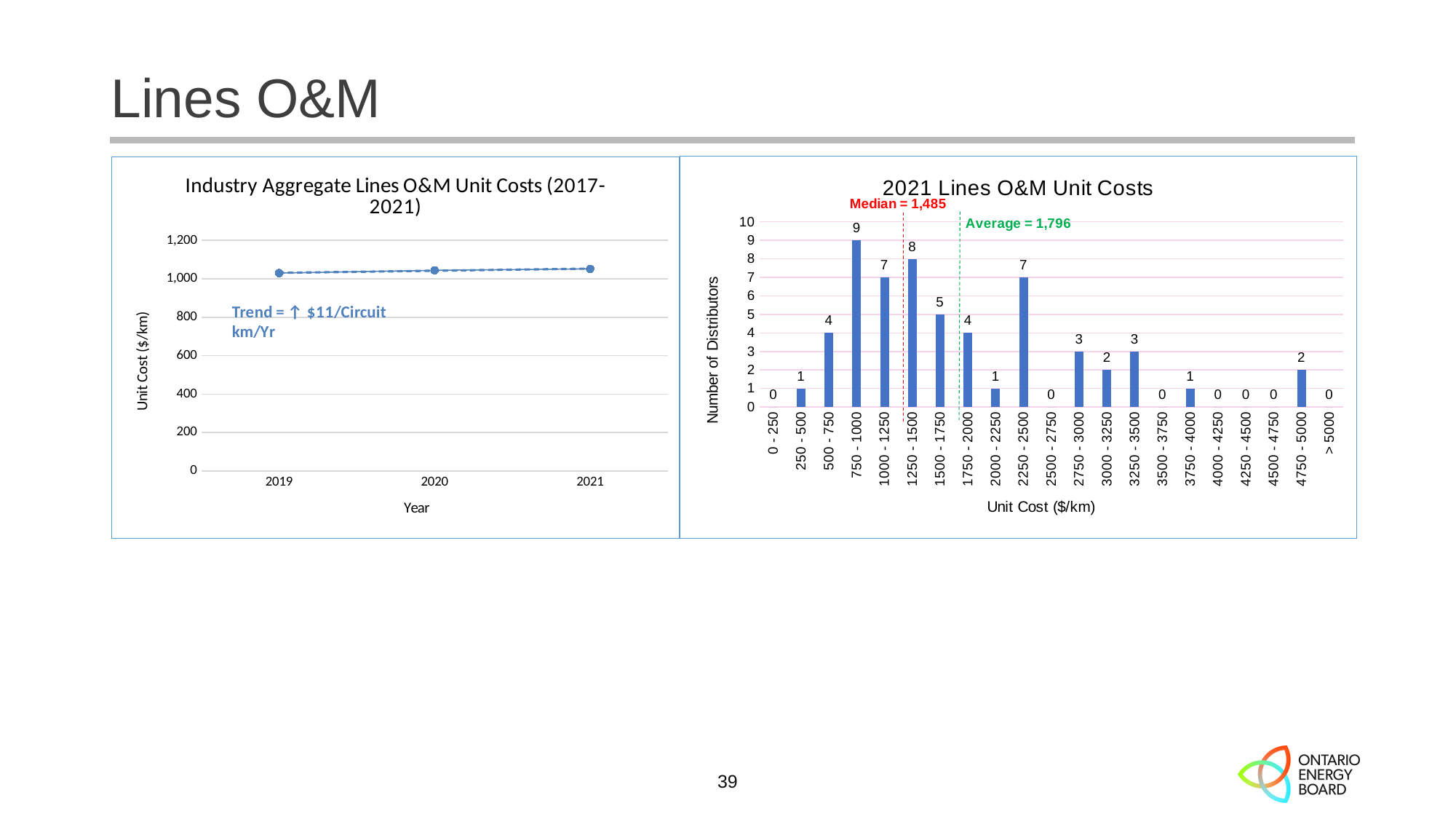
In the chart titled '2021 Lines O&M Unit Costs', how many distributors are in the 2250 - 2500 bin? 7 What kind of chart is the 'Industry Aggregate Lines O&M Unit Costs (2017-2021)' chart? Line chart In the chart titled '2021 Lines O&M Unit Costs', what is the difference between the number of distributors in the 1250 - 1500 bin and the 1500 - 1750 bin? 3 In the chart titled '2021 Lines O&M Unit Costs', what average value is annotated? 1,796 In the chart titled 'Industry Aggregate Lines O&M Unit Costs (2017-2021)', is the unit cost for 2021 greater or less than 1,000? greater In the chart titled '2021 Lines O&M Unit Costs', which bin has more distributors: 500 - 750 or 2750 - 3000? 500 - 750 In the chart titled '2021 Lines O&M Unit Costs', how many distributors fall in the 750 - 1000 bin? 9 What kind of chart is the '2021 Lines O&M Unit Costs' chart? Bar chart In the chart titled '2021 Lines O&M Unit Costs', how many unit cost bins are shown on the x axis? 21 In the chart titled '2021 Lines O&M Unit Costs', which unit cost bin has the highest number of distributors? 750 - 1000 In the chart titled '2021 Lines O&M Unit Costs', what median value is annotated? 1,485 In the chart titled 'Industry Aggregate Lines O&M Unit Costs (2017-2021)', how many years are plotted on the x axis? 3